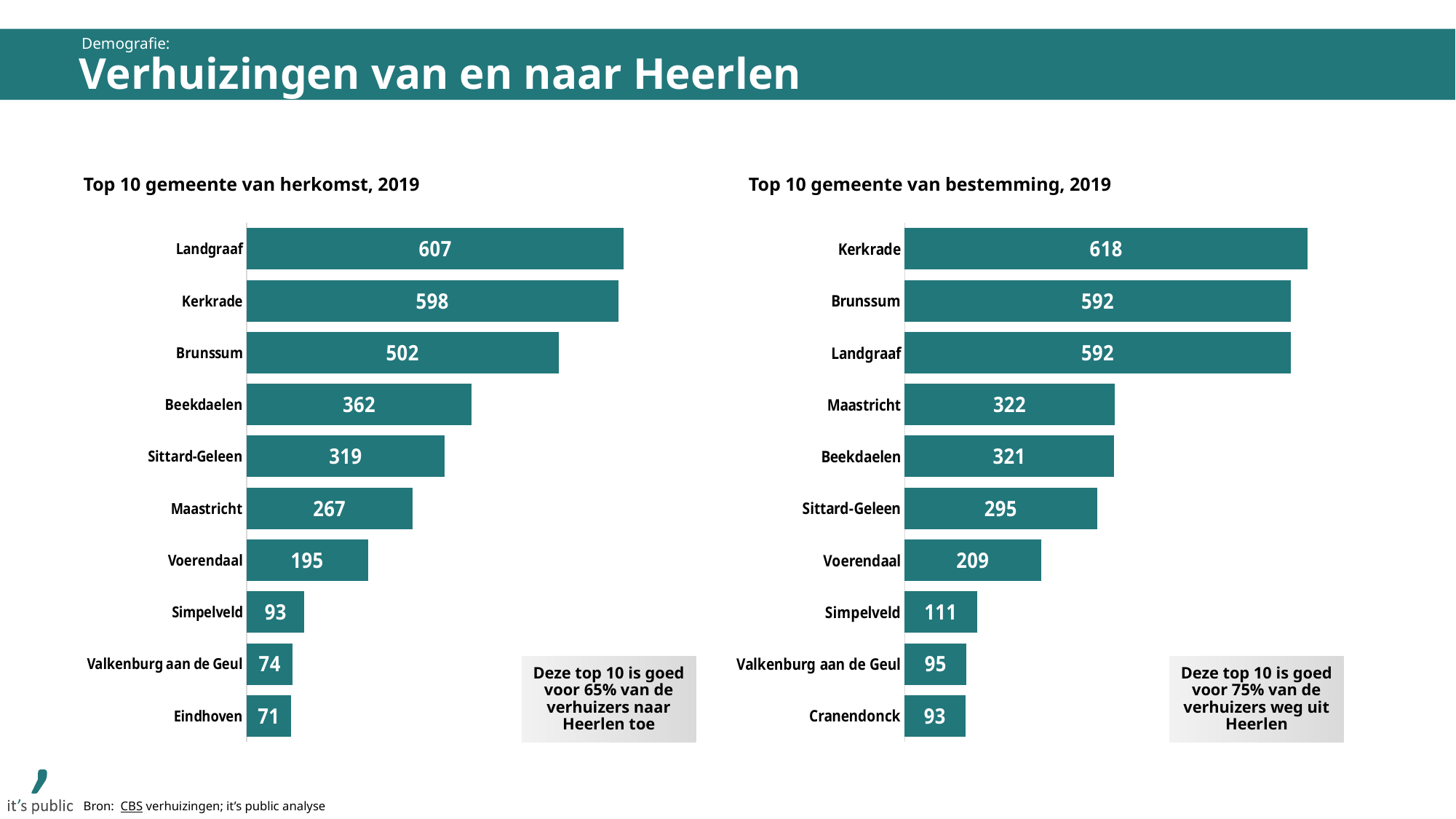
In the 'Top 10 gemeente van bestemming, 2019' chart, what is the difference between Kerkrade and Voerendaal? 409 In the 'Top 10 gemeente van herkomst, 2019' chart, which municipality has the highest value? Landgraaf In the 'Top 10 gemeente van herkomst, 2019' chart, what is the difference between Kerkrade and Brunssum? 96 In the 'Top 10 gemeente van bestemming, 2019' chart, what is the value for Sittard-Geleen? 295 How many municipalities are shown in the 'Top 10 gemeente van herkomst, 2019' chart? 10 In the 'Top 10 gemeente van herkomst, 2019' chart, what is the value for Landgraaf? 607 According to the text box next to the 'Top 10 gemeente van herkomst, 2019' chart, what share of movers to Heerlen does this top 10 account for? 65% In the 'Top 10 gemeente van bestemming, 2019' chart, what is the value for Maastricht? 322 In the 'Top 10 gemeente van bestemming, 2019' chart, which municipality has the lowest value? Cranendonck What kind of chart is the 'Top 10 gemeente van bestemming, 2019' chart? Bar chart In the 'Top 10 gemeente van herkomst, 2019' chart, which is larger: Beekdaelen or Maastricht? Beekdaelen In the 'Top 10 gemeente van bestemming, 2019' chart, which is larger: Simpelveld or Valkenburg aan de Geul? Simpelveld